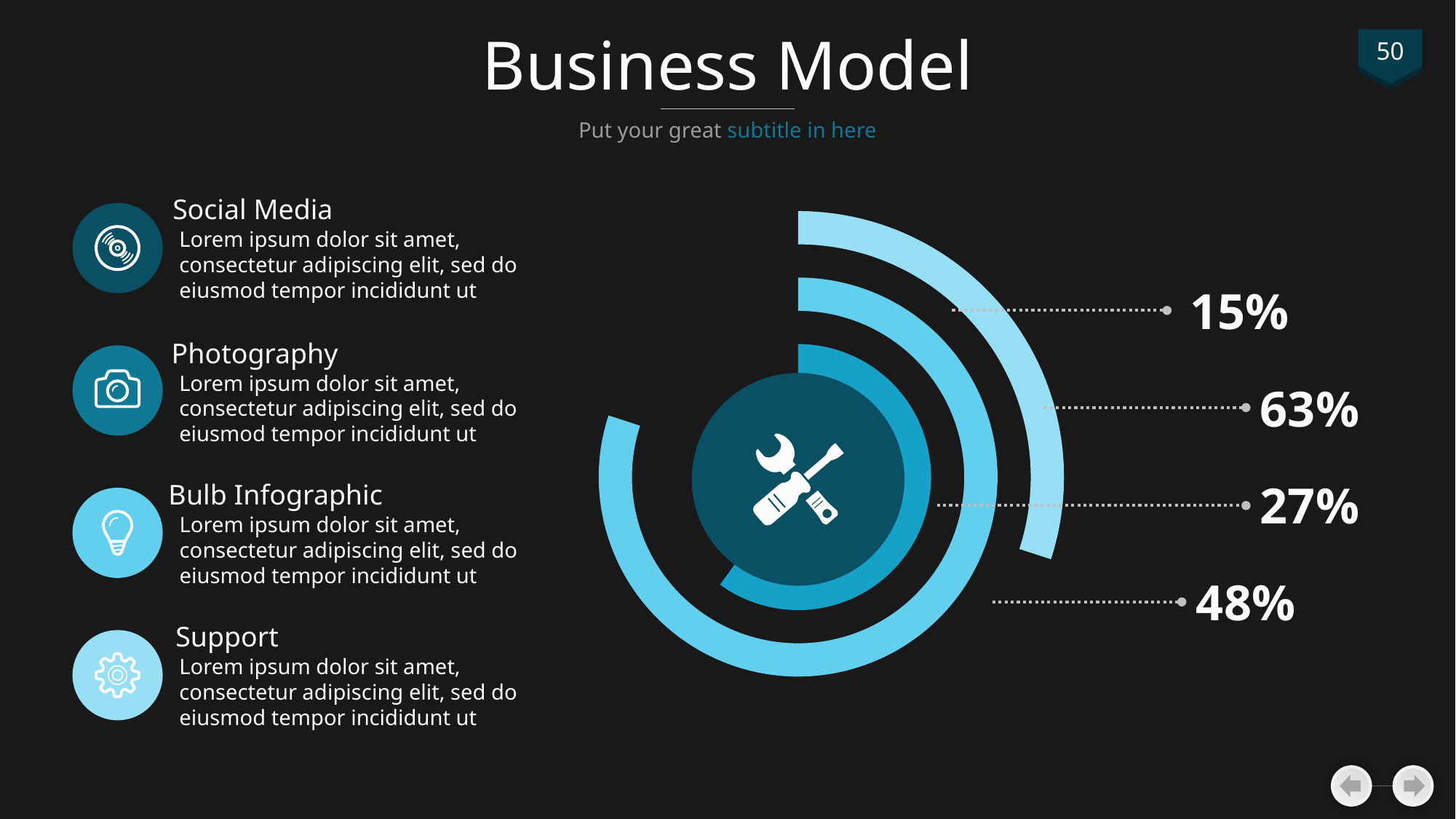
What is the difference between the highest (63%) and lowest (15%) percentages on the chart? 48 percentage points What icon appears in the centre circle of the arc chart? A wrench and screwdriver What kind of chart is shown on the slide? A ring chart made of concentric arcs How many labelled items are listed on the left side of the slide? 4 How many percentage values are labelled on the arc chart? 4 Which is larger on the chart, 27% or 48%? 48% What is the difference between the 48% and 27% values on the chart? 21 percentage points What is the lowest percentage shown on the arc chart? 15% What is the second-highest percentage shown on the arc chart? 48% What is the highest percentage shown on the arc chart? 63% What is the title of the slide containing the arc chart? Business Model